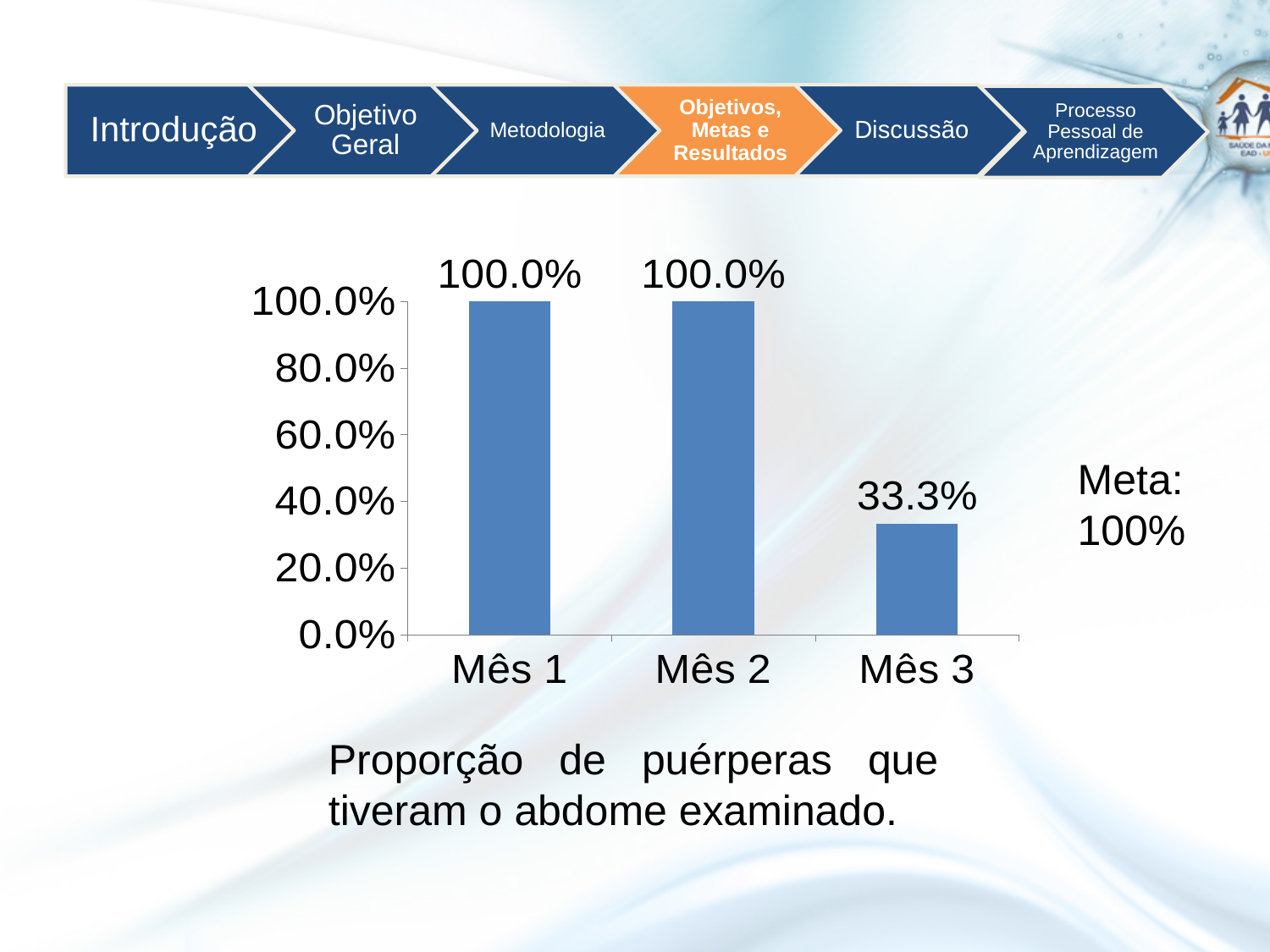
What is the value for Mês 1? 100.0% What is the target (Meta) stated next to the chart? 100% Which is larger, the value for Mês 1 or the value for Mês 3? Mês 1 What is the difference between the values for Mês 2 and Mês 3? 66.7% Which month has the lowest value? Mês 3 Is the value for Mês 3 greater or less than 40.0%? less How many months are shown on the x axis? 3 What kind of chart is shown on the slide? bar chart What is the value for Mês 2? 100.0% What is the value for Mês 3? 33.3% Do the values rise or fall from Mês 2 to Mês 3? fall What is the caption below the chart? Proporção de puérperas que tiveram o abdome examinado.